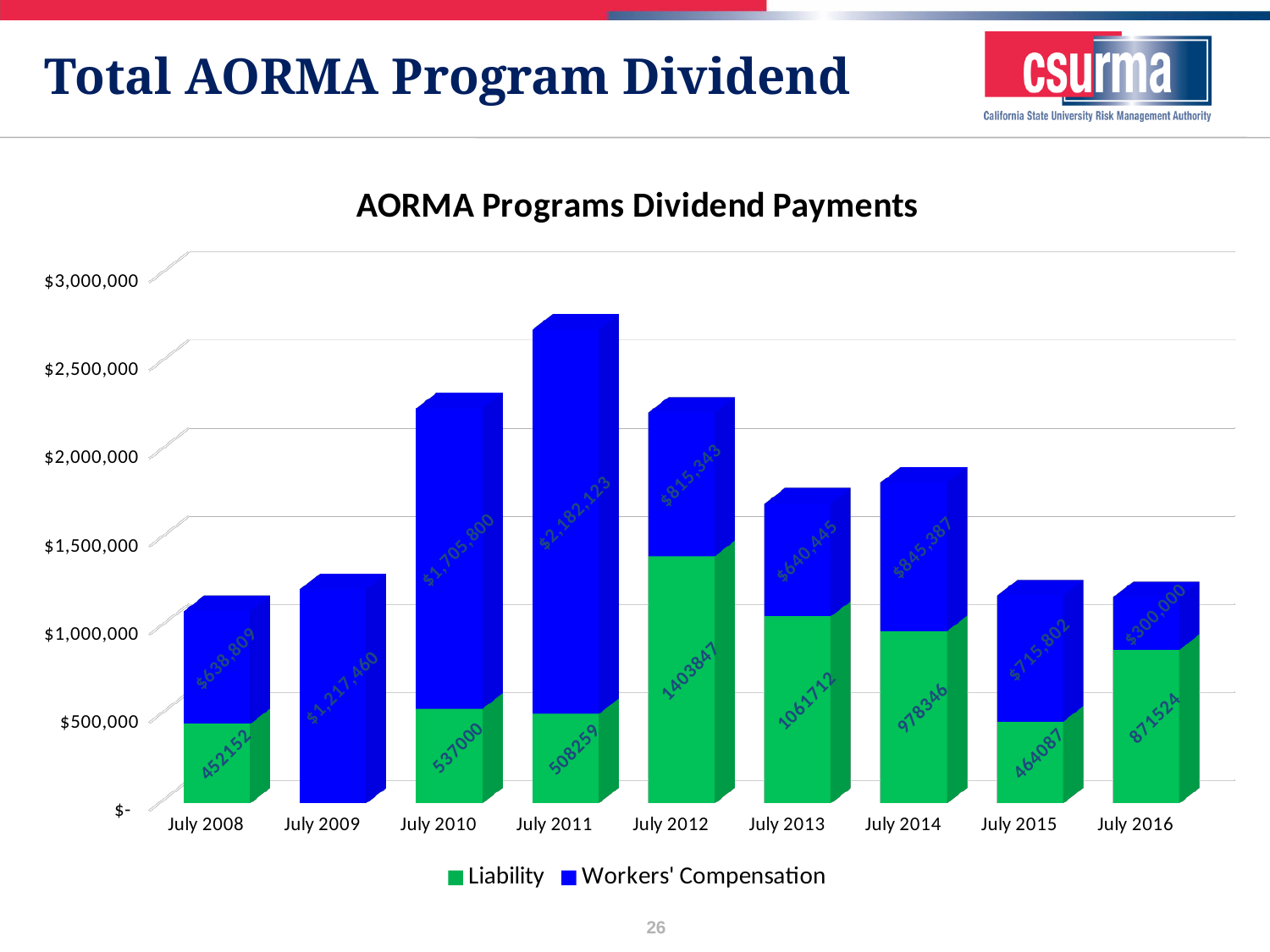
What is the difference between the Workers' Compensation values for July 2011 and July 2010? $476,323 Which month has the highest Workers' Compensation value? July 2011 Is the Liability value larger for July 2014 or July 2015? July 2014 What is the Liability value for July 2012? 1403847 How many months are shown on the x axis? 9 Which month has the highest Liability value? July 2012 What is the Workers' Compensation value for July 2009? $1,217,460 Which month has the lowest Workers' Compensation value? July 2016 What is the total of the stacked bar for July 2016? $1,171,524 What kind of chart is shown on the slide? Stacked bar chart What is the Workers' Compensation value for July 2011? $2,182,123 How many series does the legend list? 2